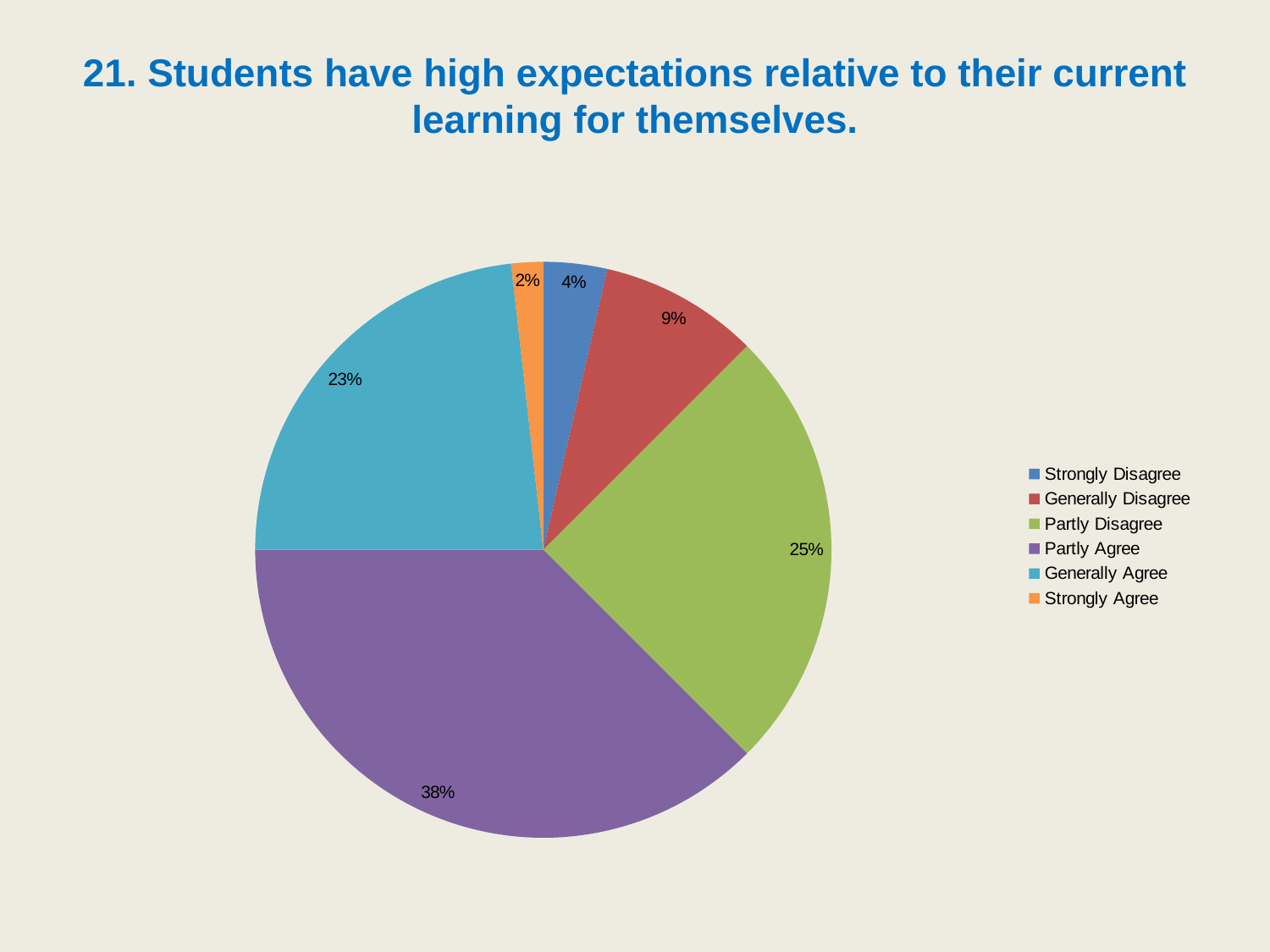
What colour is the Partly Agree slice? purple How many categories does the legend list? 6 What percentage of the pie is Generally Disagree? 9% Which is larger, the share for Generally Agree or the share for Generally Disagree? Generally Agree What percentage of the pie is Strongly Agree? 2% What is the difference in percentage points between Partly Agree and Partly Disagree? 13 What percentage of the pie is Partly Disagree? 25% What percentage of the pie is Partly Agree? 38% What percentage of the pie is Generally Agree? 23% Which category has the smallest share of the pie? Strongly Agree Which category has the largest share of the pie? Partly Agree What kind of chart is shown on the slide? pie chart